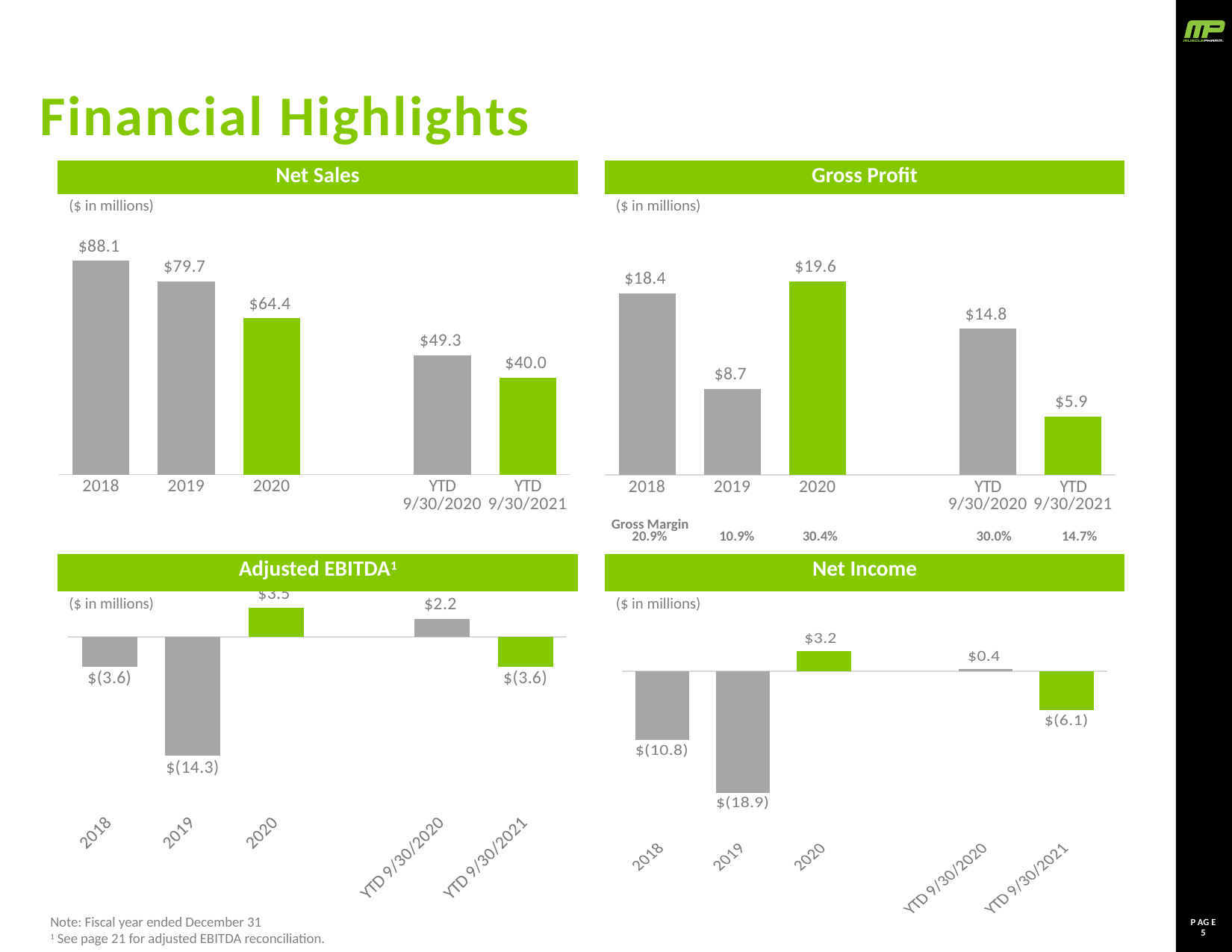
In the Adjusted EBITDA chart, what is the value for 2019? $(14.3) In the Net Sales chart, what is the difference between the 2019 and 2020 values? $15.3 In the Net Sales chart, what is the value for 2018? $88.1 In the Gross Profit chart, which year has the highest gross profit? 2020 What type of chart is the Net Sales chart? Bar chart How many bars are plotted in the Net Income chart? 5 In the Gross Profit chart, what is the gross margin shown for 2019? 10.9% In the Adjusted EBITDA chart, which is larger, the value for 2020 or the value for YTD 9/30/2020? 2020 In the Net Income chart, which category has the lowest value? 2019 In the Gross Profit chart, what is the value for YTD 9/30/2020? $14.8 In the Net Sales chart, which category has the lowest value? YTD 9/30/2021 In the Net Income chart, what is the value for YTD 9/30/2021? $(6.1)